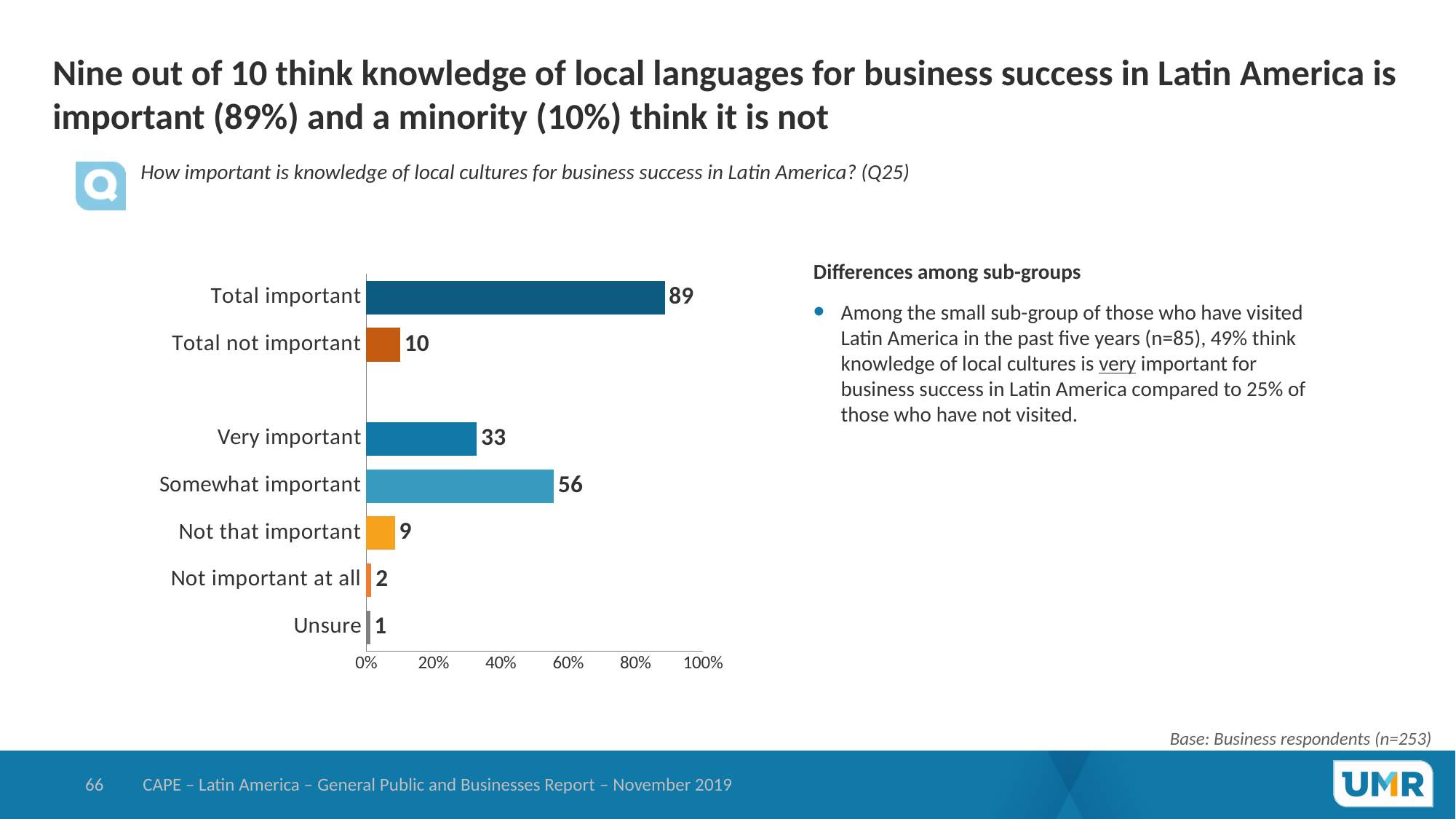
What is the value for Total important? 89 Is the value for Total important greater or less than 80%? greater How many categories are shown in the chart? 7 What is the difference between Total important and Total not important? 79 What is the value for Somewhat important? 56 What is the difference between Somewhat important and Very important? 23 Which is larger, Very important or Not that important? Very important Which category has the highest value? Total important Which category has the lowest value? Unsure What is the value for Not that important? 9 What kind of chart is shown on the slide? bar chart What is the value for Unsure? 1